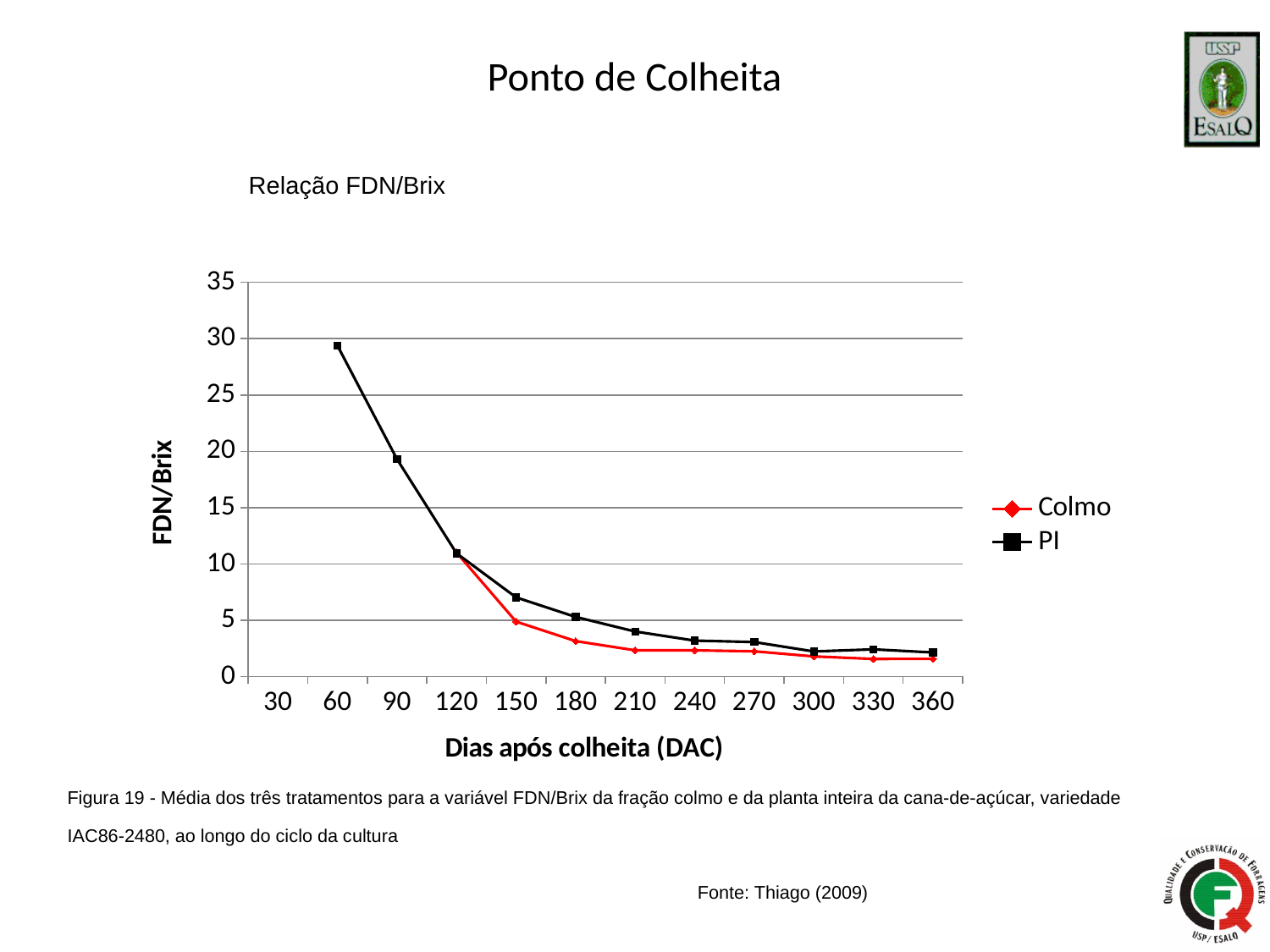
What are the two series named in the legend? Colmo and PI Is the PI value at 90 DAC greater or less than 20? less Is the Colmo value at 360 DAC greater or less than 5? less Do the FDN/Brix values for PI rise or fall as days after harvest increase? fall What kind of chart is shown on the slide? line chart Is the PI value at 60 DAC greater or less than 25? greater At 180 DAC, which series has the lower FDN/Brix value, Colmo or PI? Colmo At which DAC value does the PI series reach its highest FDN/Brix? 60 What is the title of the x axis? Dias após colheita (DAC) How many series does the legend list? 2 At 150 DAC, which series has the higher FDN/Brix value, Colmo or PI? PI